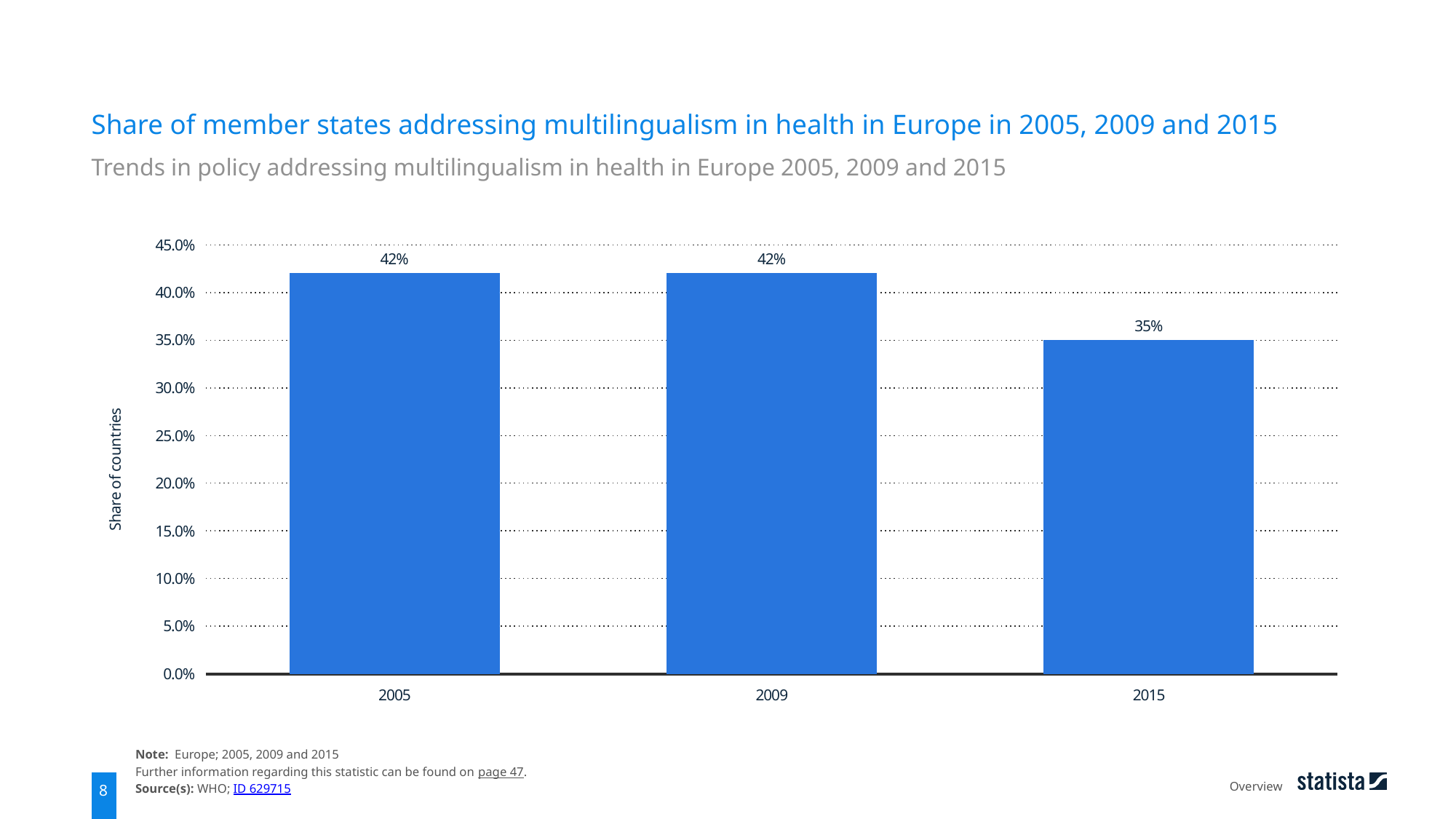
What is the share of countries for 2009? 42% What is the label of the y axis? Share of countries Is the value for 2005 greater or less than 40.0%? greater Which is larger, the share for 2005 or the share for 2015? 2005 How many years are shown on the x axis? 3 What kind of chart is shown on the slide? bar chart Is the value for 2015 greater or less than 40.0%? less Which year has the lowest share of countries? 2015 What is the difference between the share for 2009 and the share for 2015? 7% What is the share of countries for 2005? 42% Does the share of countries rise or fall from 2009 to 2015? fall What is the share of countries for 2015? 35%